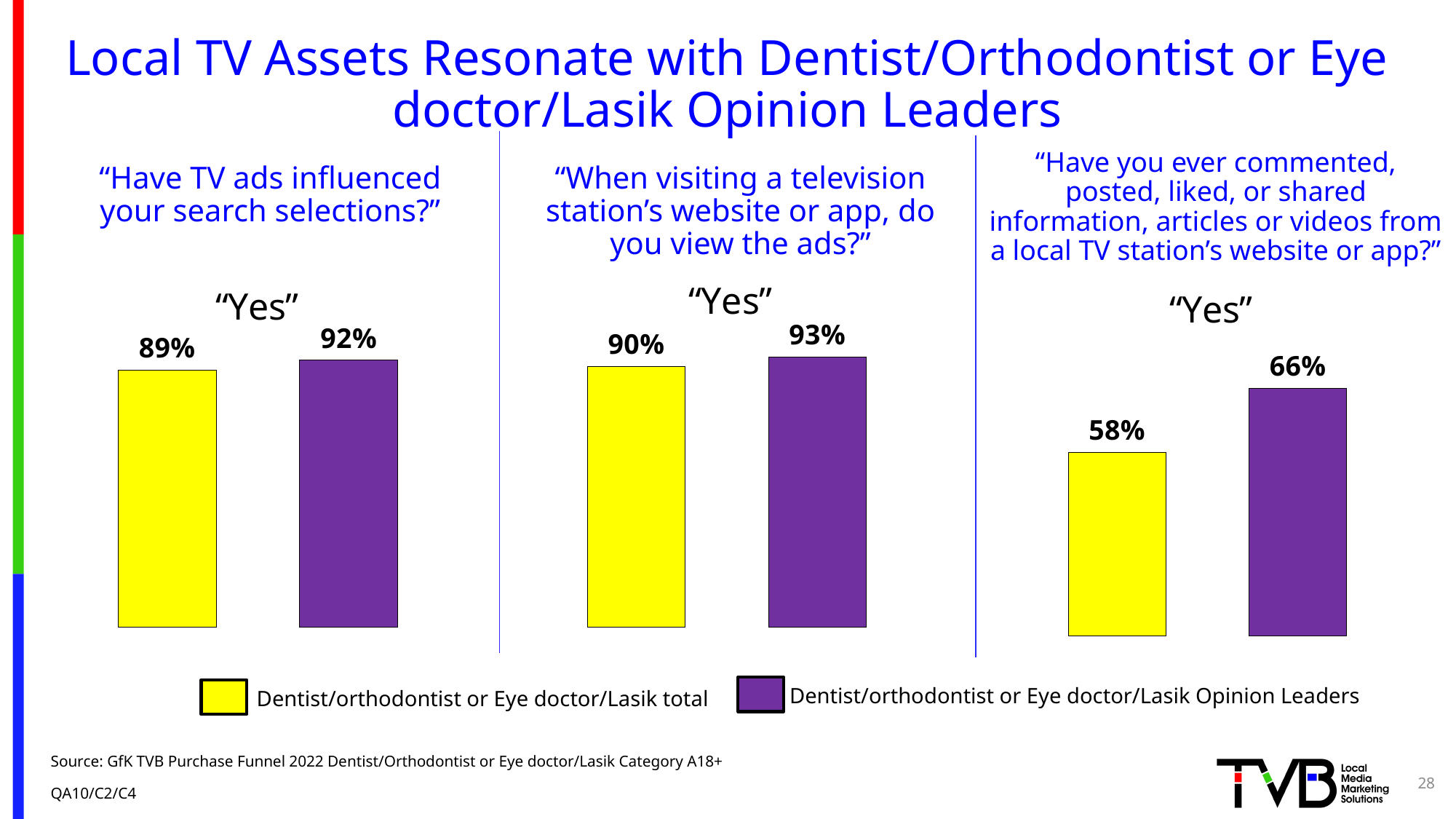
In the middle chart ("When visiting a television station's website or app, do you view the ads?"), what is the value for the Dentist/orthodontist or Eye doctor/Lasik total? 90% In the left chart ("Have TV ads influenced your search selections?"), what percentage of the Dentist/orthodontist or Eye doctor/Lasik total answered "Yes"? 89% In the left chart ("Have TV ads influenced your search selections?"), what percentage of Opinion Leaders answered "Yes"? 92% Which colour represents the Dentist/orthodontist or Eye doctor/Lasik Opinion Leaders in the charts? Purple What type of chart is used for the three charts on the slide? Bar chart In the right chart ("Have you ever commented, posted, liked, or shared..."), what is the difference between the Opinion Leaders value and the total value? 8 percentage points In the right chart ("Have you ever commented, posted, liked, or shared..."), what is the value for Opinion Leaders? 66% In the middle chart ("When visiting a television station's website or app, do you view the ads?"), what is the value for Opinion Leaders? 93% How many series does the legend at the bottom of the slide list? 2 In the left chart ("Have TV ads influenced your search selections?"), what is the difference between the Opinion Leaders value and the total value? 3 percentage points In the middle chart ("When visiting a television station's website or app, do you view the ads?"), which group has the higher "Yes" percentage? Dentist/orthodontist or Eye doctor/Lasik Opinion Leaders In the right chart ("Have you ever commented, posted, liked, or shared..."), what is the value for the Dentist/orthodontist or Eye doctor/Lasik total? 58%